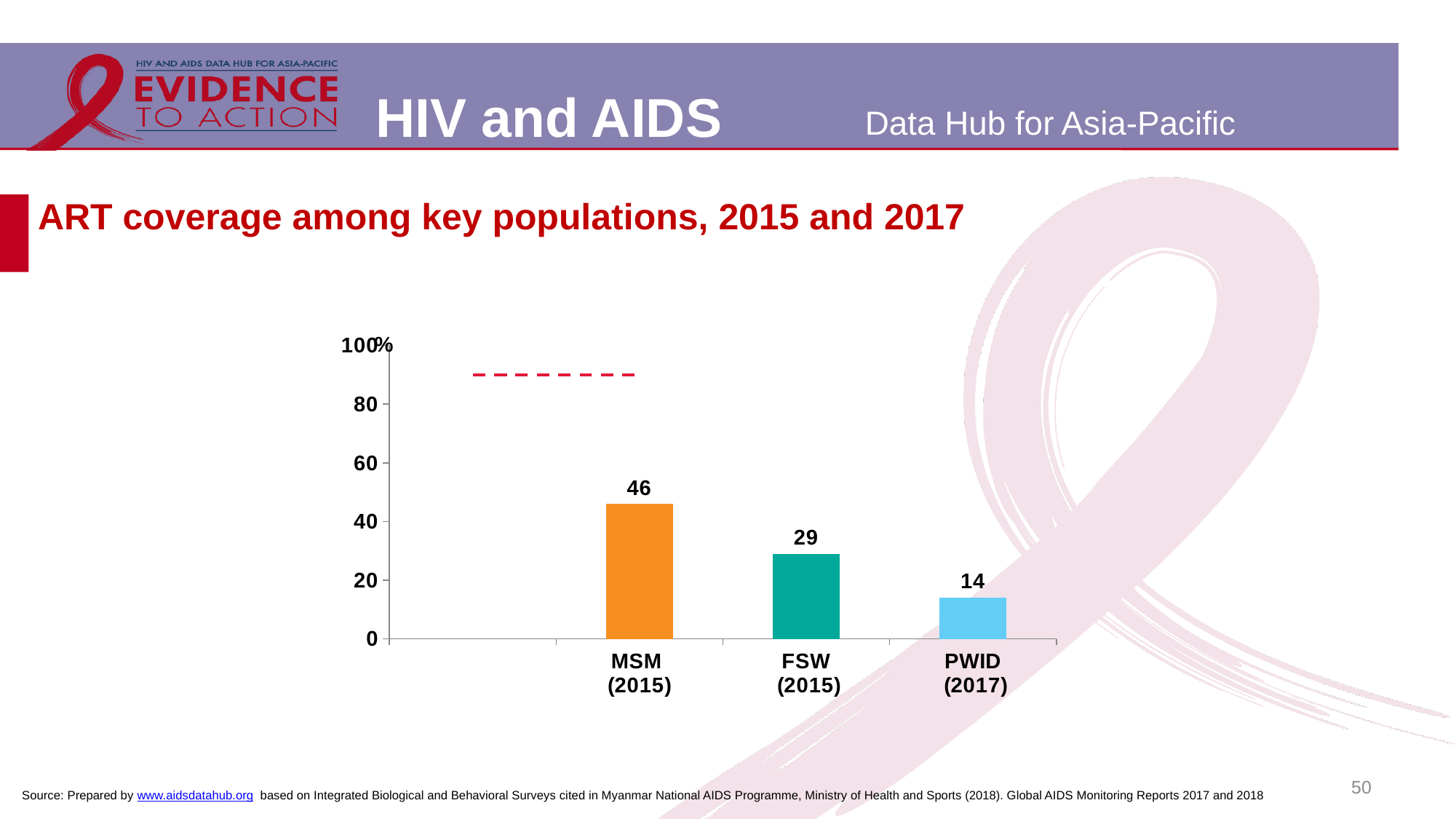
What is the difference between the ART coverage for FSW (2015) and PWID (2017)? 15 Which is larger, the ART coverage for FSW (2015) or PWID (2017)? FSW (2015) Which key population has the highest ART coverage? MSM (2015) How many key population categories are shown in the chart? 3 Which key population has the lowest ART coverage? PWID (2017) What is the difference between the ART coverage for MSM (2015) and FSW (2015)? 17 What is the title of the chart on the slide? ART coverage among key populations, 2015 and 2017 What is the ART coverage value for MSM (2015)? 46 Is the value for MSM (2015) greater or less than 40? greater What is the ART coverage value for FSW (2015)? 29 What kind of chart is shown on the slide? Bar chart What is the ART coverage value for PWID (2017)? 14